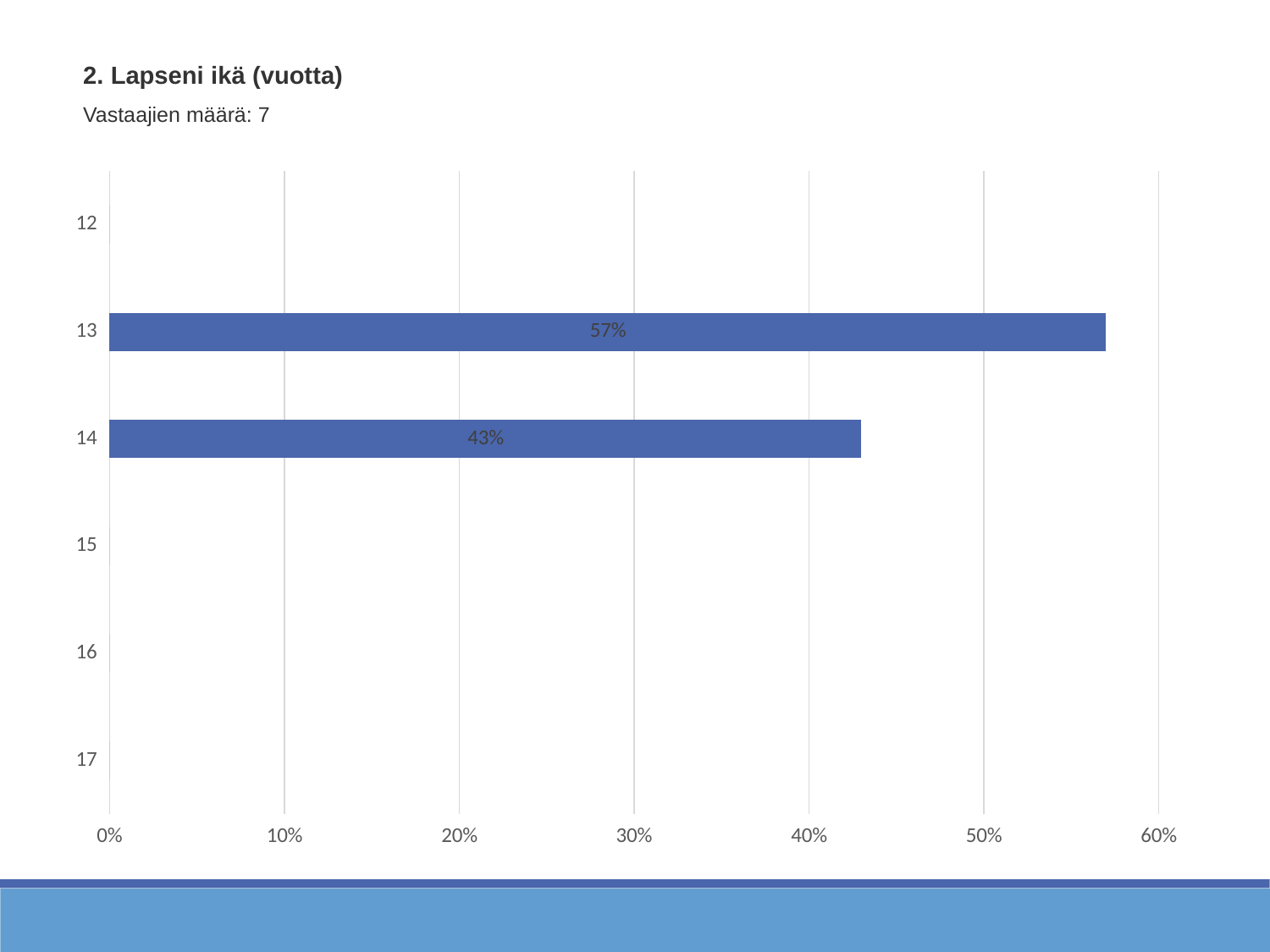
What is the title of the chart? 2. Lapseni ikä (vuotta) Is the value for age 13 greater or less than 50%? greater What is the value for age 14? 43% Which age category has the highest value? 13 How many respondents does the slide report (Vastaajien määrä)? 7 What kind of chart is shown on the slide? bar chart Is the value for age 14 greater or less than 40%? greater How many age categories have a visible bar? 2 How many age categories are listed on the vertical axis? 6 Which is larger, the value for age 13 or the value for age 14? 13 What is the value for age 13? 57% What is the difference between the values for age 13 and age 14? 14%